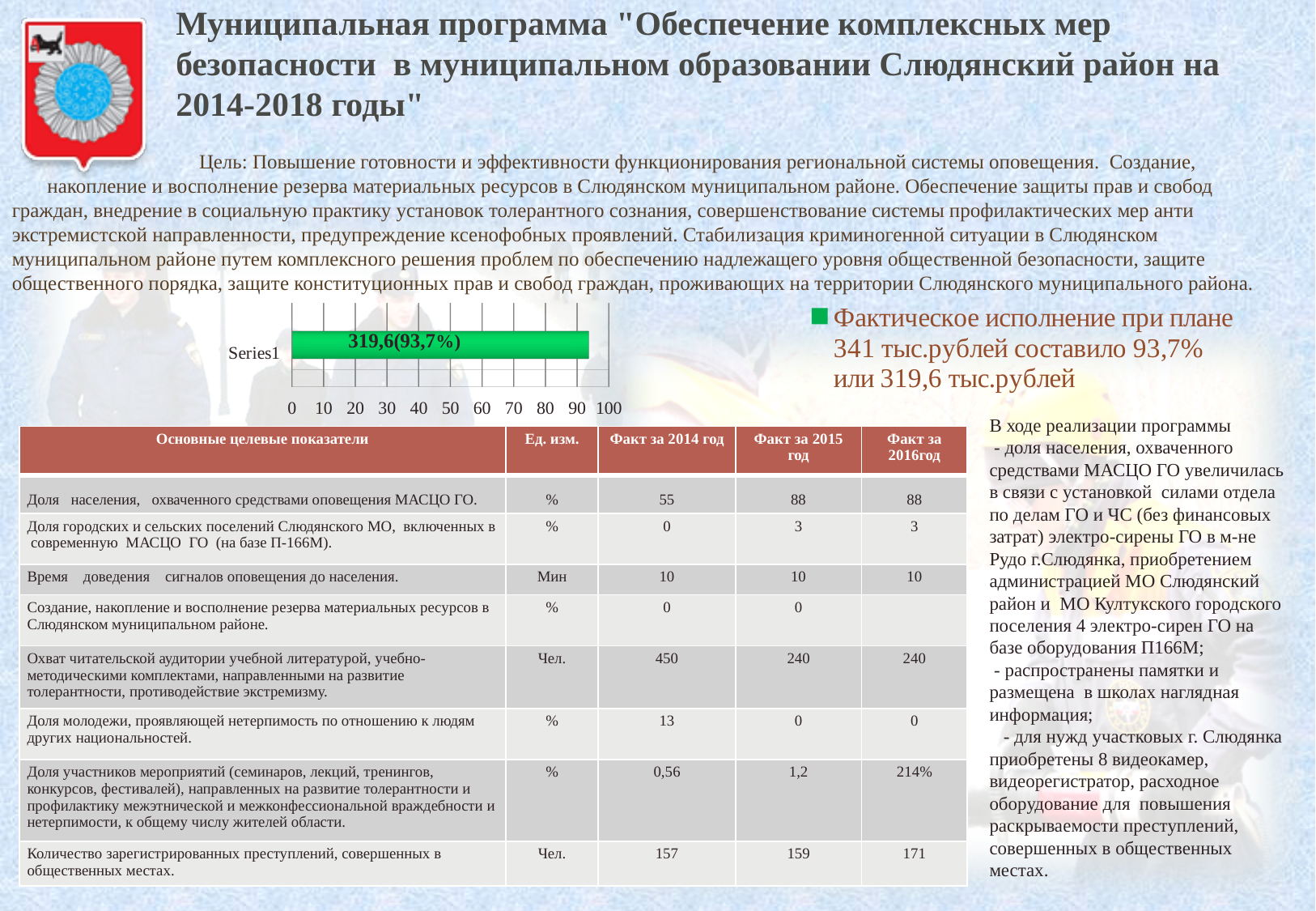
What kind of chart is shown on the slide? bar chart What percentage is shown in parentheses in the bar's data label? 93,7% Is the value for Series1 on the chart's axis greater or less than 80? greater What is the data label printed on the bar for Series1? 319,6(93,7%) How many bars does the chart show? 1 Is the value for Series1 on the chart's axis greater or less than 50? greater What is the label of the category shown on the chart's vertical axis? Series1 What is the highest tick value shown on the chart's horizontal axis? 100